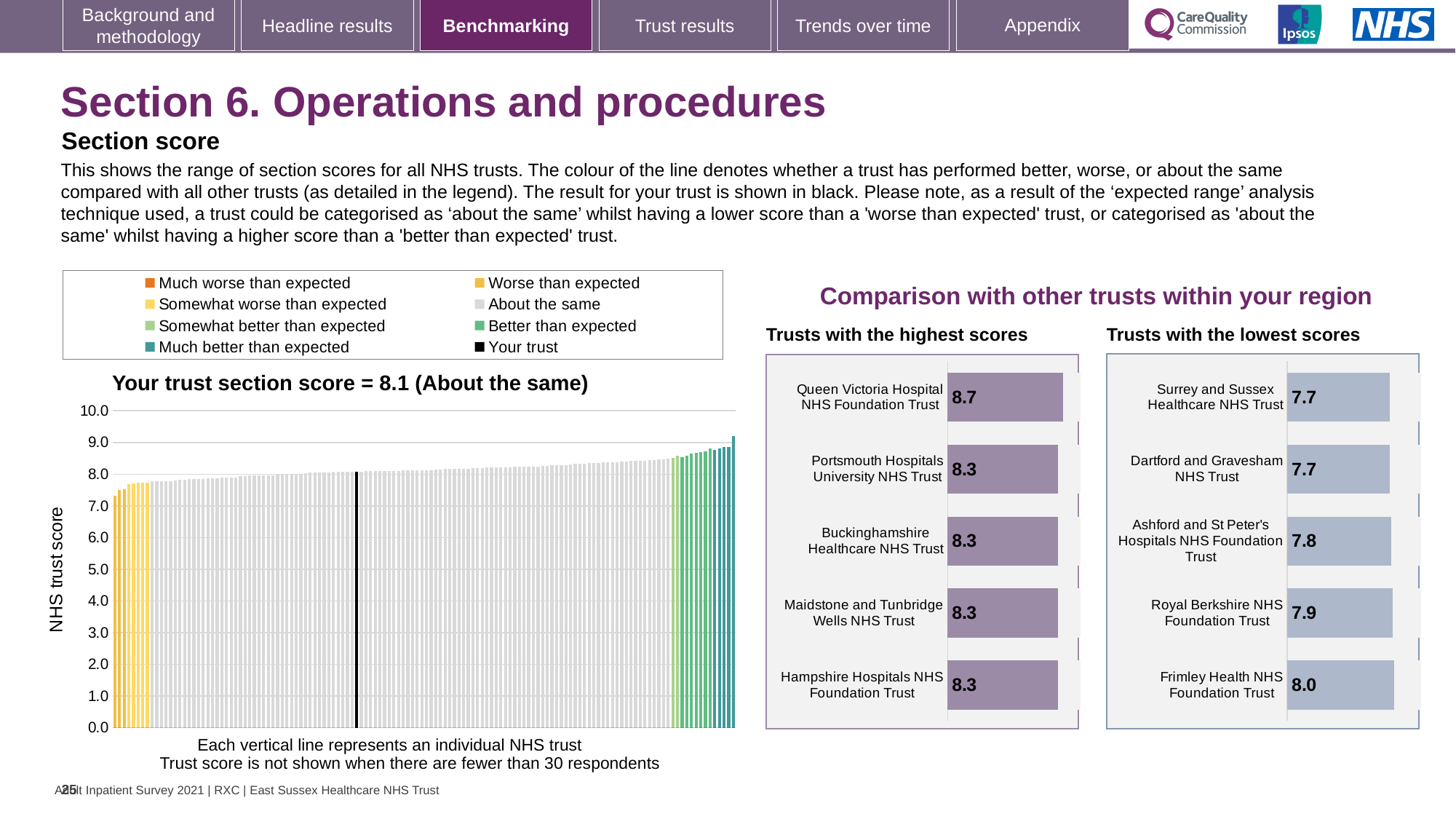
In the 'Trusts with the highest scores' chart, what is the score for Queen Victoria Hospital NHS Foundation Trust? 8.7 In the 'Your trust section score' chart, do the values rise or fall from left to right along the x axis? rise In the 'Trusts with the lowest scores' chart, which has the larger score: Ashford and St Peter's Hospitals NHS Foundation Trust or Royal Berkshire NHS Foundation Trust? Royal Berkshire NHS Foundation Trust In the 'Trusts with the highest scores' chart, what is the difference between the scores of Queen Victoria Hospital NHS Foundation Trust and Hampshire Hospitals NHS Foundation Trust? 0.4 In the 'Trusts with the lowest scores' chart, what is the score for Royal Berkshire NHS Foundation Trust? 7.9 In the 'Your trust section score' chart, what is the section score for your trust? 8.1 How many entries does the legend above the 'Your trust section score' chart list? 8 What kind of chart is the 'Your trust section score' chart on the left of the slide? bar chart In the 'Trusts with the highest scores' chart, how many trusts are shown? 5 In the 'Trusts with the highest scores' chart, which trust has the highest score? Queen Victoria Hospital NHS Foundation Trust In the 'Trusts with the lowest scores' chart, which trust has the highest score? Frimley Health NHS Foundation Trust What is the y-axis label of the 'Your trust section score' chart? NHS trust score